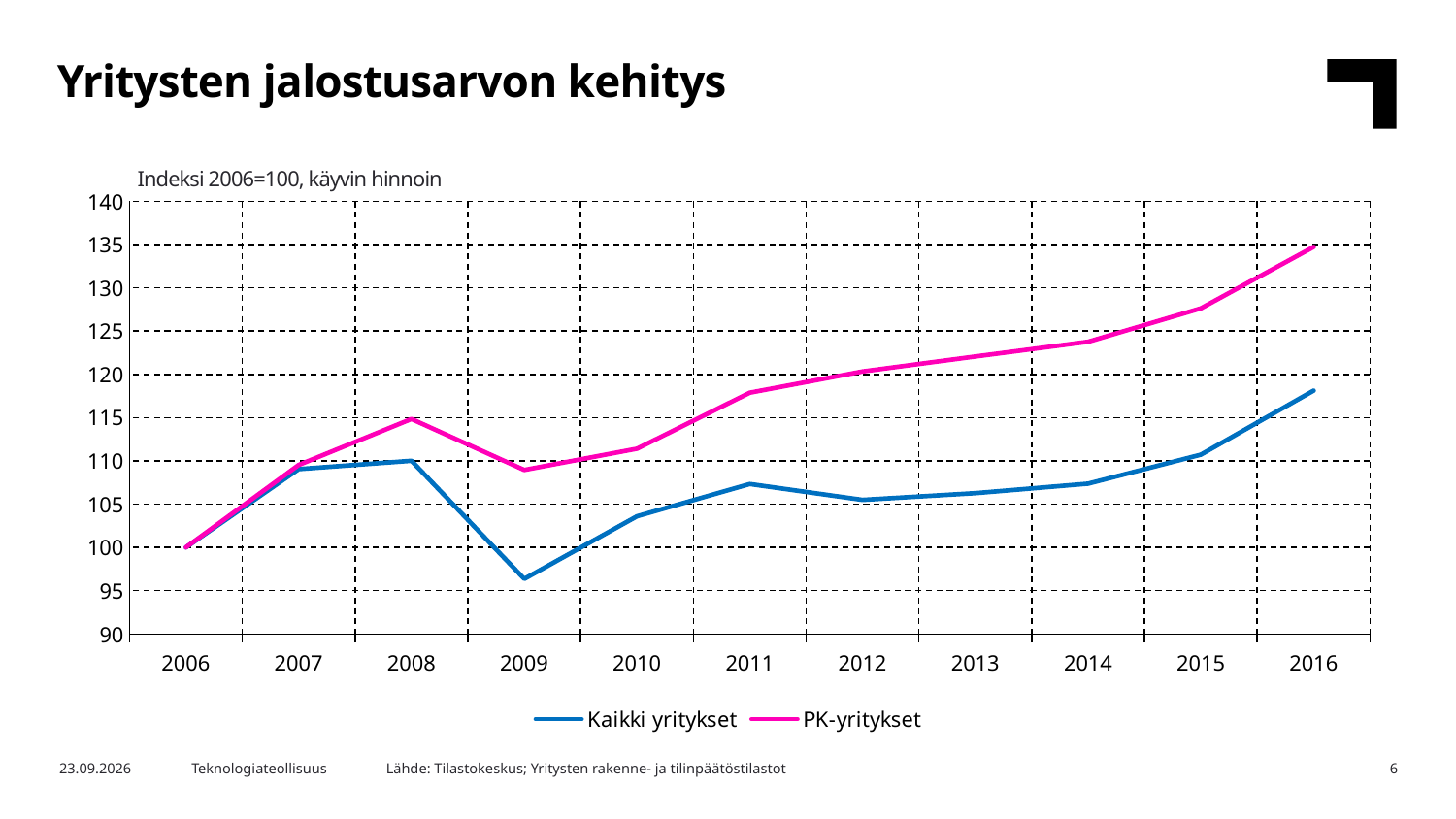
In which year is the value for PK-yritykset highest? 2016 Is the value for PK-yritykset in 2016 greater or less than 130? greater Does the value for Kaikki yritykset rise or fall from 2009 to 2016? rise How many series does the legend list? 2 How many years are shown on the x axis? 11 In 2016, which series has the larger value, Kaikki yritykset or PK-yritykset? PK-yritykset What is the title of the chart on the slide? Yritysten jalostusarvon kehitys What is the value for PK-yritykset in 2006? 100 What kind of chart is shown on the slide? line chart Is the value for Kaikki yritykset in 2009 greater or less than 100? less In which year is the value for Kaikki yritykset lowest? 2009 What is the value for Kaikki yritykset in 2006? 100